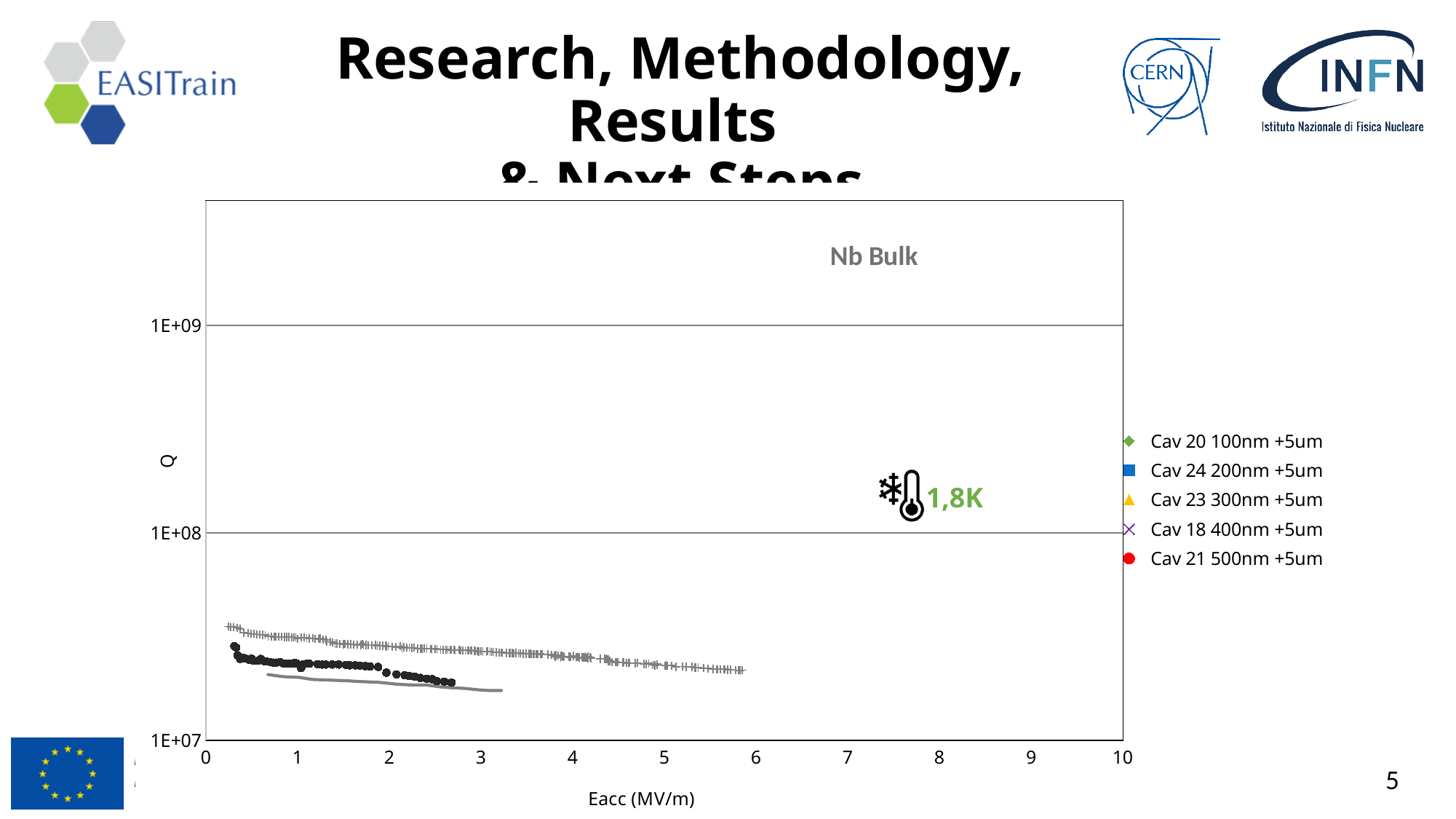
What is the label of the chart's x axis? Eacc (MV/m) What kind of chart is shown on the slide? scatter chart Are the plotted Q values greater or less than 1E+08? less Is the highest plotted Q value greater or less than 1E+09? less Which legend entry is listed last in the chart's legend? Cav 21 500nm +5um Are the plotted Q values greater or less than 1E+07? greater Do the plotted Q values rise or fall as Eacc increases along the x axis? fall How many series does the chart's legend list? 5